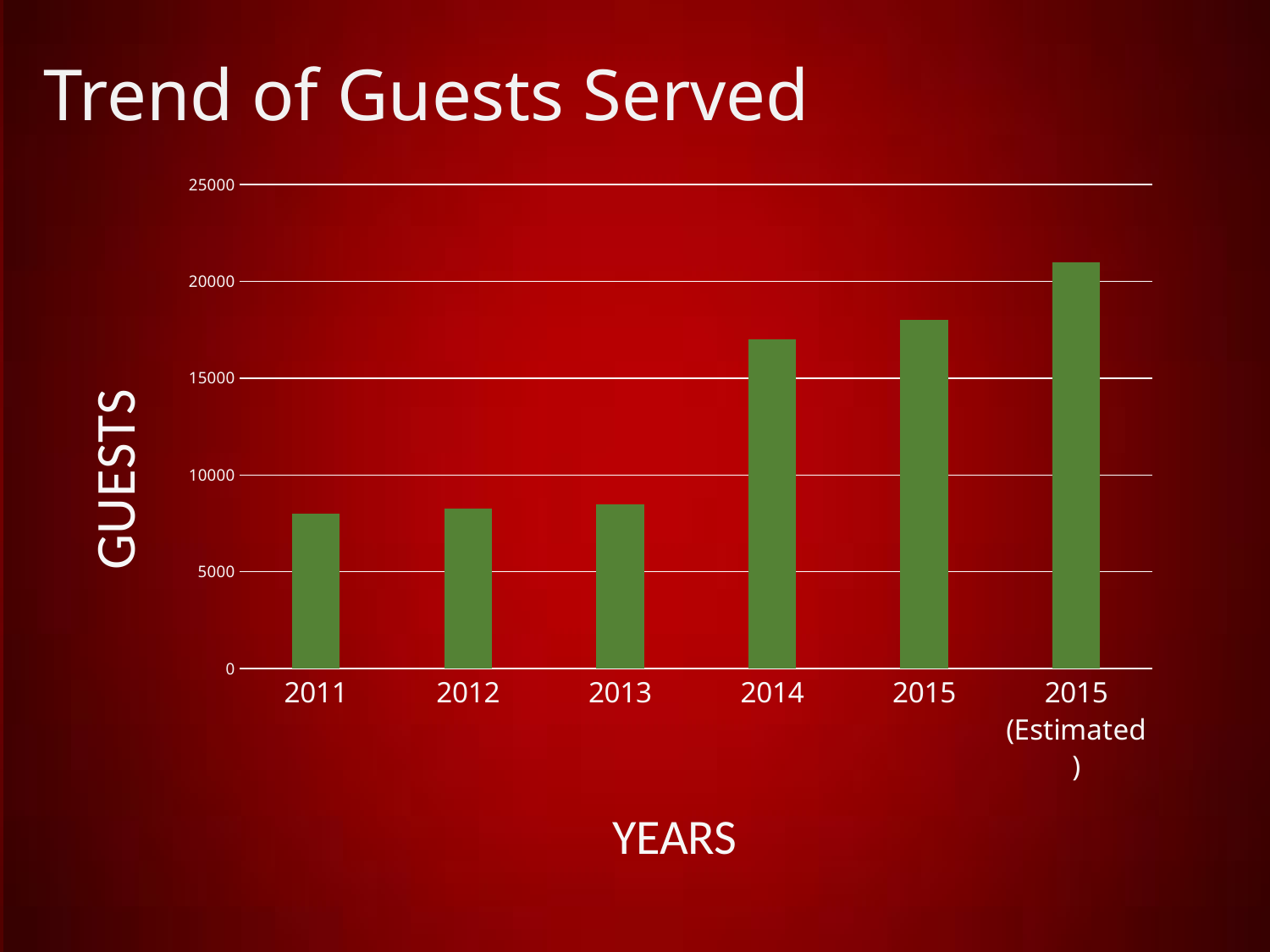
What is the label of the vertical axis? GUESTS Is the value for 2015 greater or less than 20000? less What kind of chart is shown on the slide? bar chart What is the title of the chart? Trend of Guests Served Is the value for 2013 greater or less than 10000? less Which year has the highest number of guests served? 2015 (Estimated) Is the value for 2014 greater or less than 15000? greater How many bars (categories) are plotted on the chart? 6 Which is larger, the value for 2013 or the value for 2014? 2014 Do the values generally rise or fall from 2011 to 2015 (Estimated)? rise